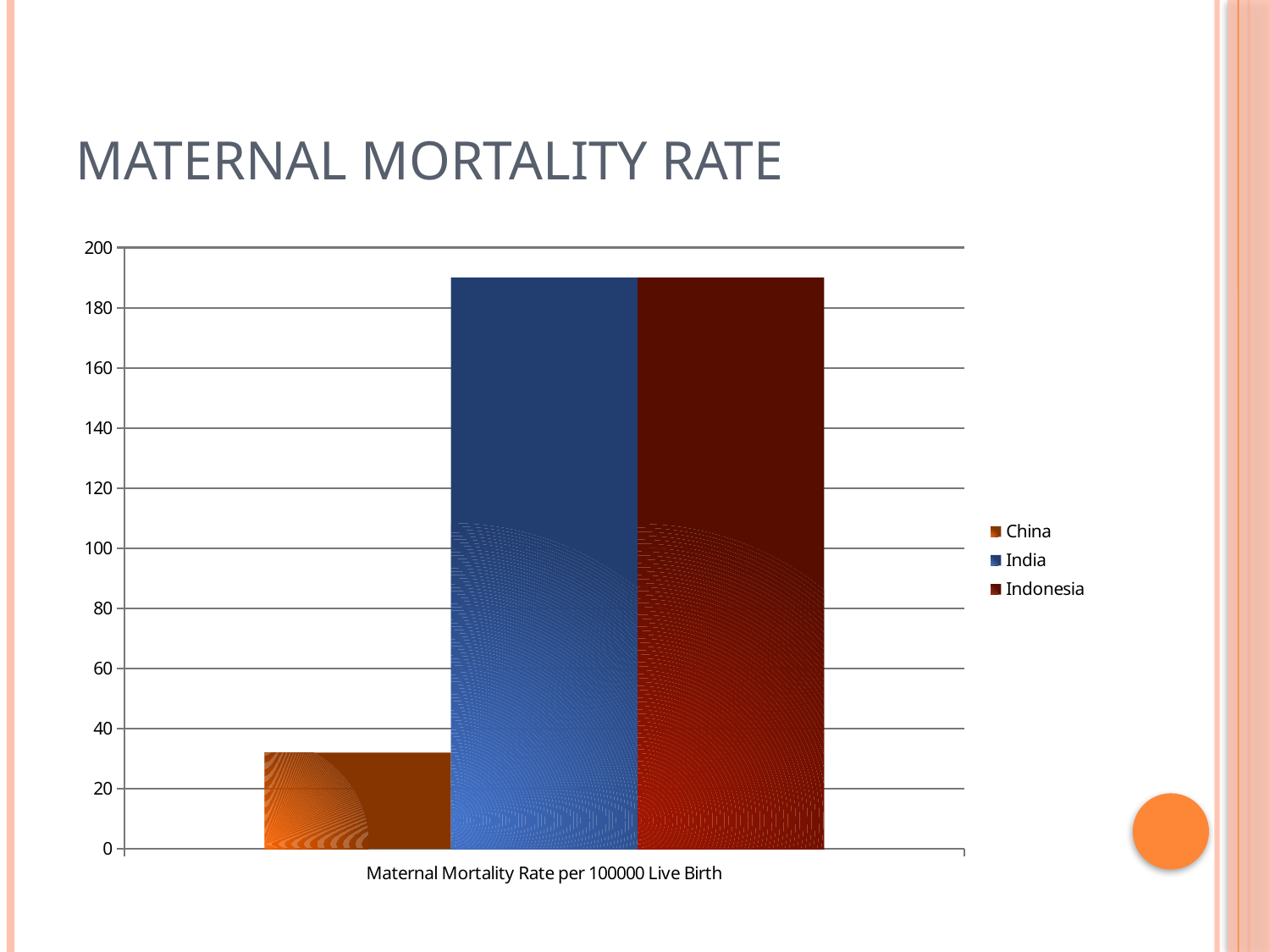
How many categories are shown on the x axis? 1 Is the value for Indonesia greater or less than 180? greater Is the value for India greater or less than 180? greater Which series has the lowest maternal mortality rate? China What is the label shown under the x axis of the chart? Maternal Mortality Rate per 100000 Live Birth Is the value for China greater or less than 40? less What is the title of the slide? MATERNAL MORTALITY RATE What kind of chart is shown on the slide? bar chart How many series does the legend list? 3 Which is larger, the value for China or the value for India? India Which is larger, the value for Indonesia or the value for China? Indonesia